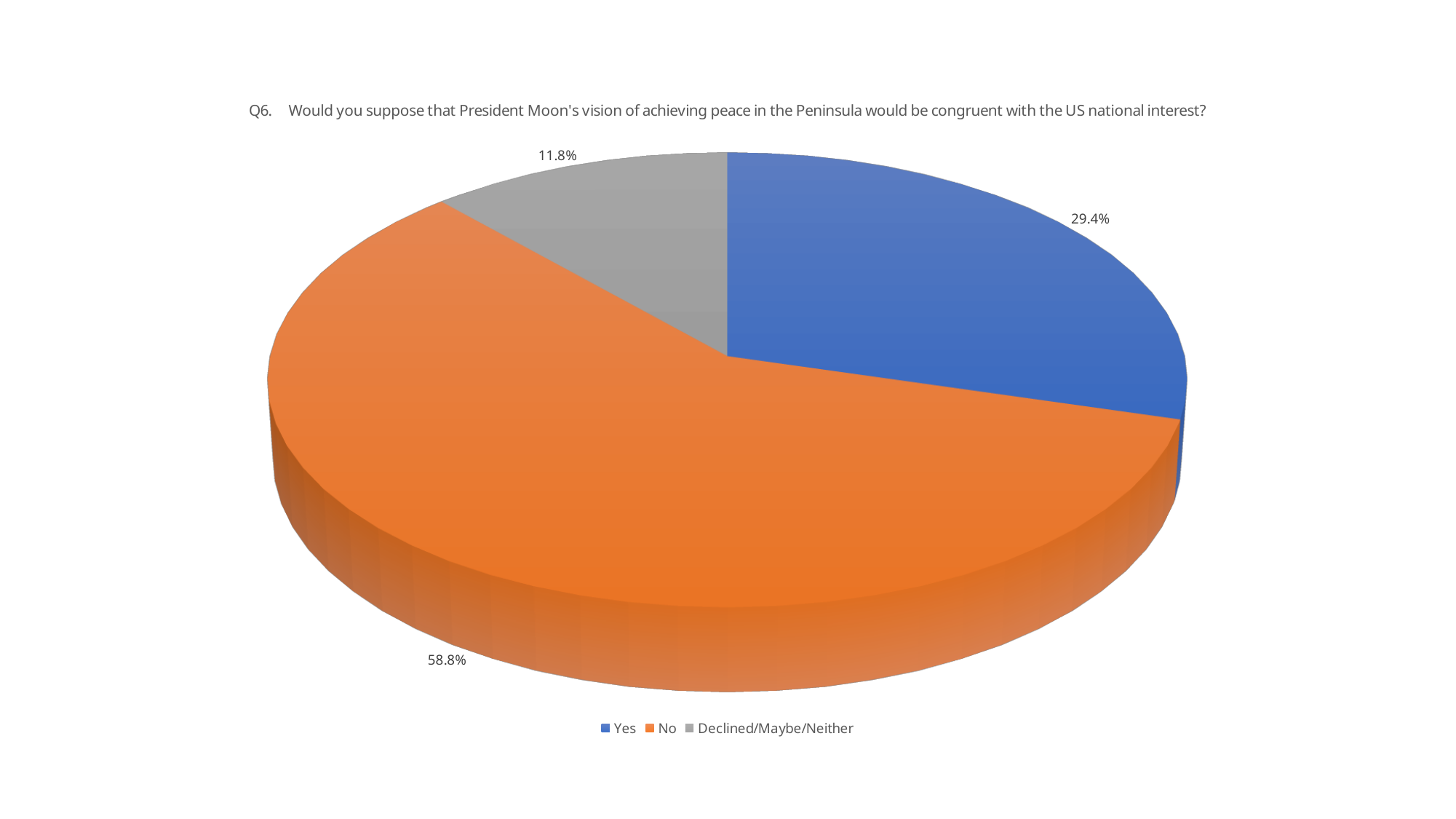
Which response has the smallest share of the pie? Declined/Maybe/Neither What kind of chart is shown on the slide? Pie chart What is the difference in percentage points between the "Yes" and "Declined/Maybe/Neither" shares? 17.6 What is the question number shown in the chart title? Q6 How many slices does the pie chart have? 3 What percentage of respondents answered "Declined/Maybe/Neither"? 11.8% What percentage of respondents answered "Yes"? 29.4% What percentage of respondents answered "No"? 58.8% Which is larger, the share for "Yes" or the share for "Declined/Maybe/Neither"? Yes What is the difference in percentage points between the "No" and "Yes" shares? 29.4 Which response has the largest share of the pie? No What colour is the slice representing "No"? Orange